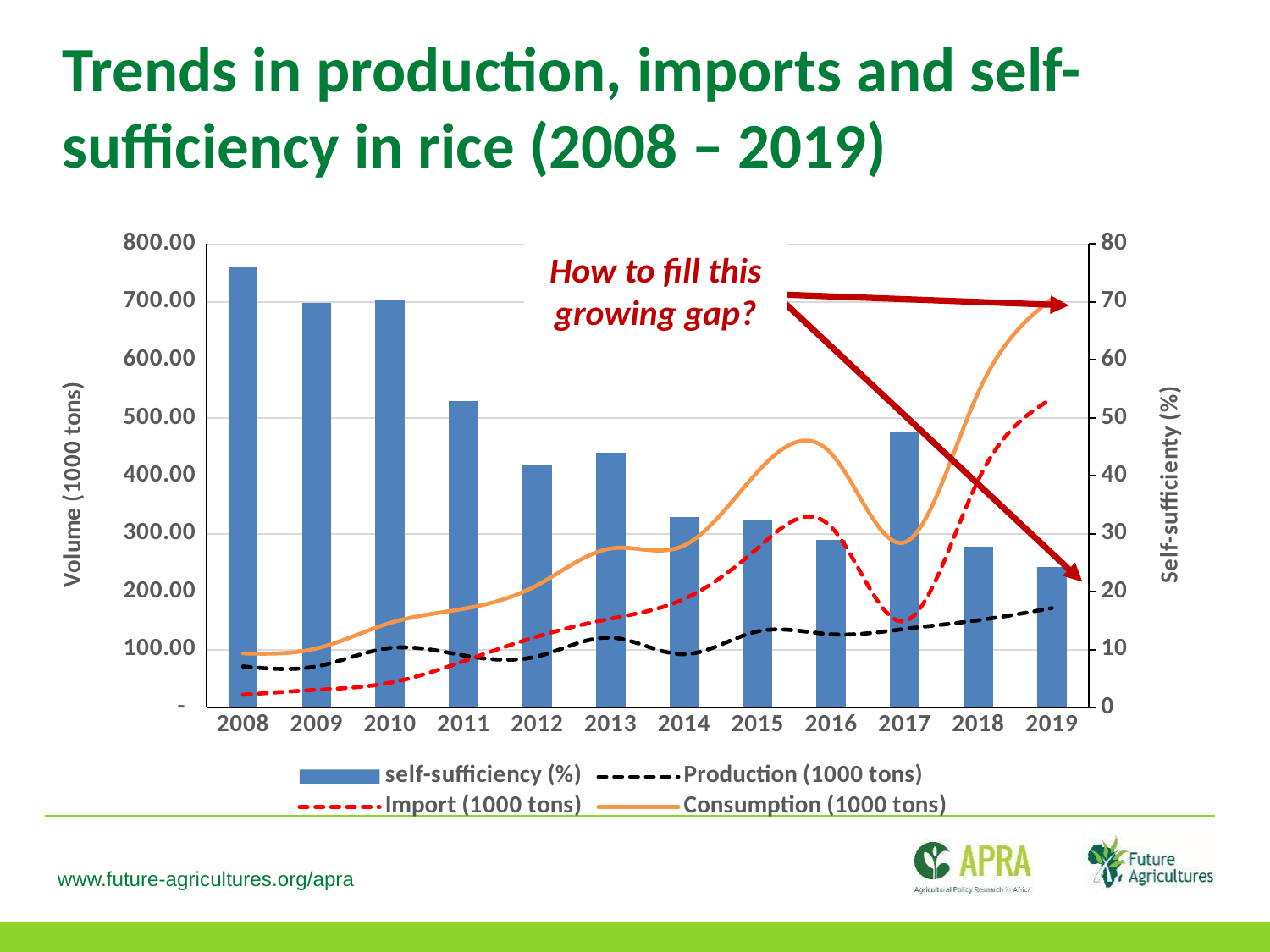
Is the self-sufficiency (%) value for 2008 greater or less than 70? greater In 2019, which is larger: Consumption (1000 tons) or Production (1000 tons)? Consumption (1000 tons) Is the self-sufficiency (%) value for 2017 greater or less than 40? greater Which year has the lowest self-sufficiency (%) bar? 2019 What kind of chart is shown on the slide? Combined bar and line chart Is the Production (1000 tons) value for 2019 greater or less than 200? less How many series does the legend list? 4 How many years are shown on the x axis? 12 Which year has the highest self-sufficiency (%) bar? 2008 Does the Consumption (1000 tons) line generally rise or fall from 2008 to 2019? rise